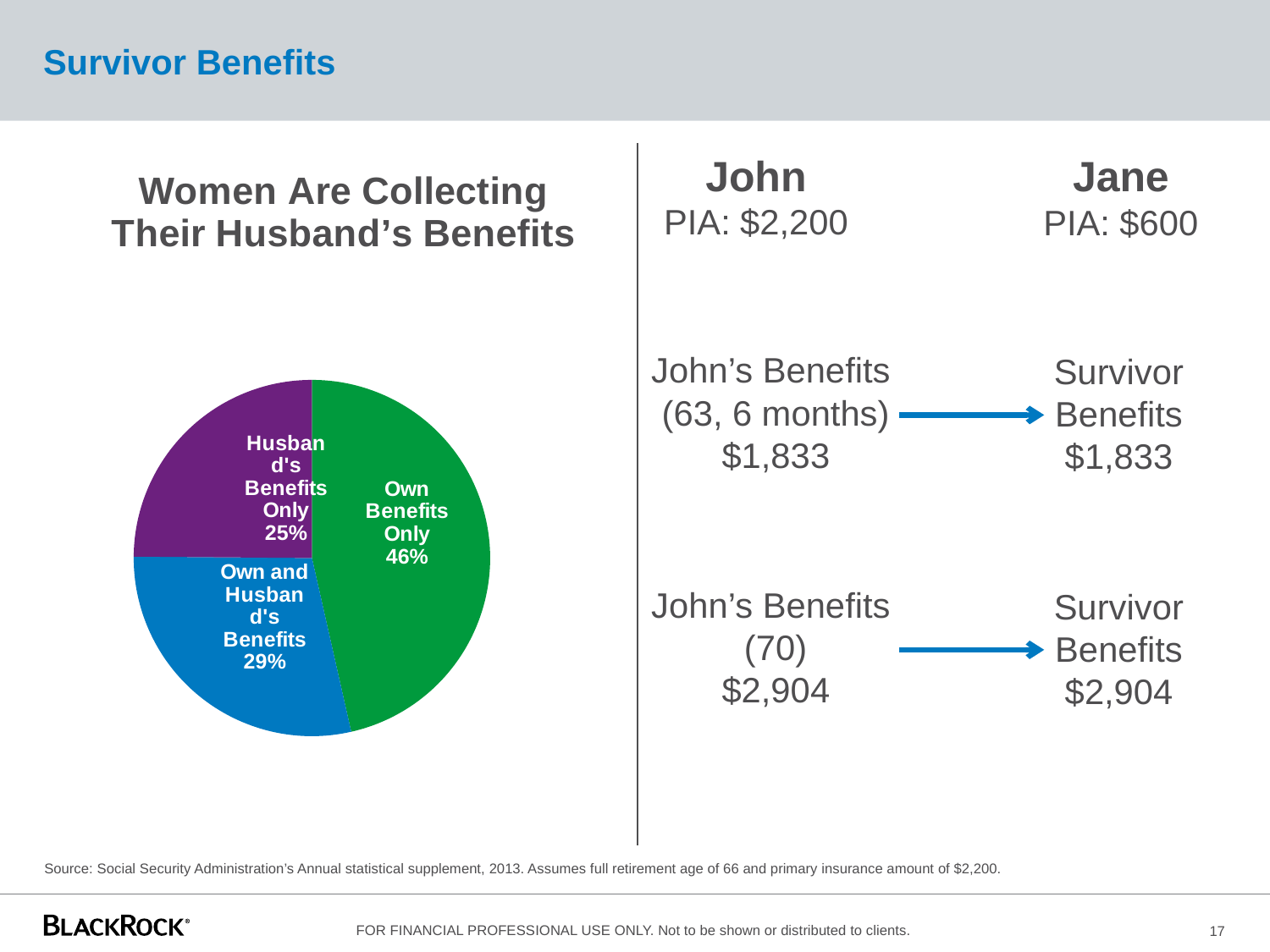
Which is larger: the "Own and Husband's Benefits" slice or the "Husband's Benefits Only" slice? Own and Husband's Benefits What share of the pie is labelled "Own and Husband's Benefits"? 29% What colour is the "Own Benefits Only" slice? Green What is the combined share of the "Husband's Benefits Only" and "Own and Husband's Benefits" slices? 54% What is the title above the pie chart? Women Are Collecting Their Husband's Benefits How many slices does the pie chart have? 3 What kind of chart is shown on the slide? Pie chart What share of the pie is labelled "Husband's Benefits Only"? 25% What share of the pie is labelled "Own Benefits Only"? 46% Which slice of the pie is the smallest? Husband's Benefits Only What is the difference in percentage points between the "Own Benefits Only" slice and the "Husband's Benefits Only" slice? 21 percentage points Which slice of the pie is the largest? Own Benefits Only